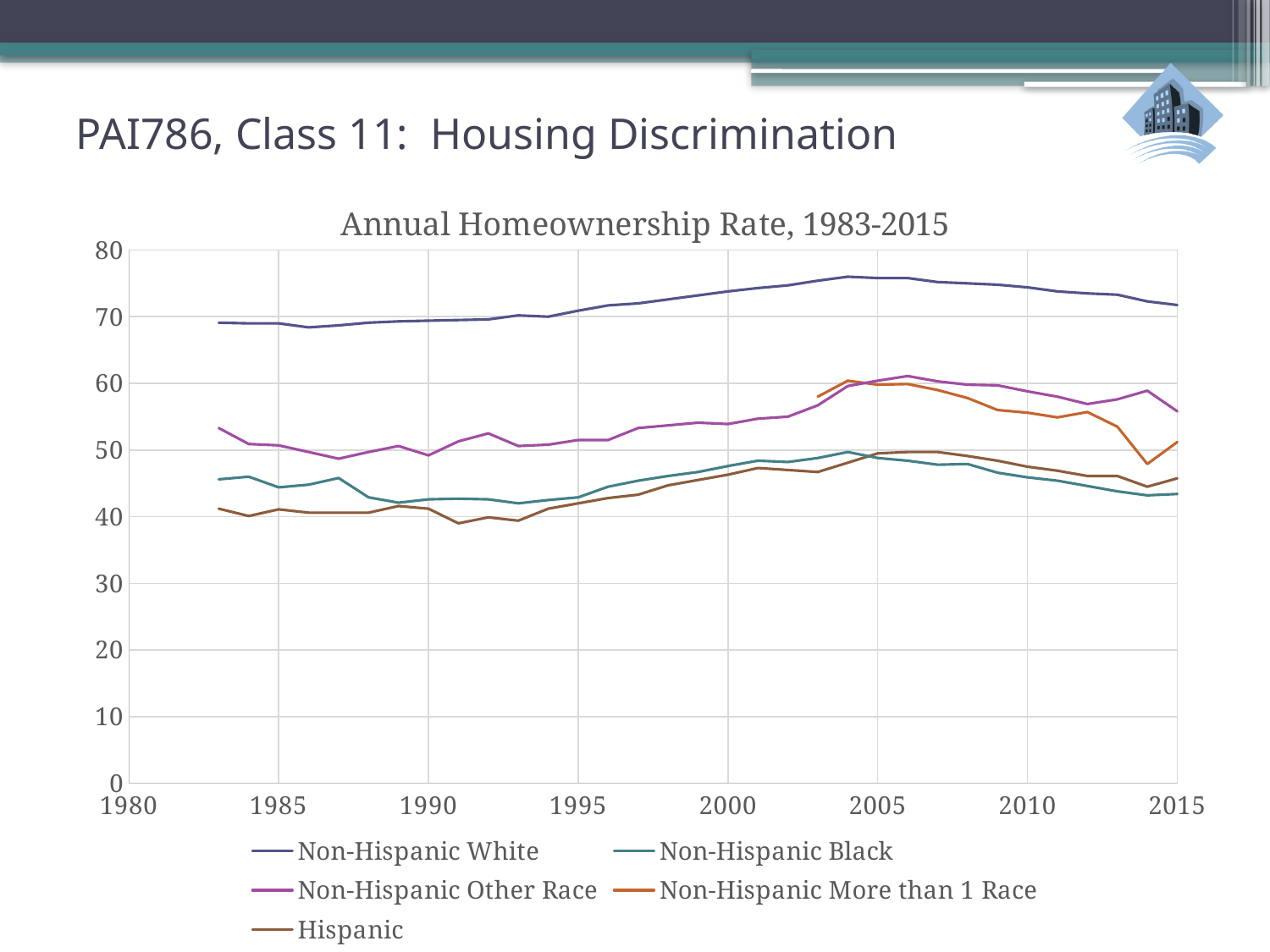
Is the value for Non-Hispanic White in 2005 greater or less than 70? greater How many series does the legend list? 5 Which series has the lowest value in 1983? Hispanic What kind of chart is shown on the slide? line chart In 2015, which is larger: the value for Non-Hispanic White or the value for Non-Hispanic Black? Non-Hispanic White Is the value for Non-Hispanic Black in 2005 greater or less than 60? less Which series begins latest on the chart, with no data before about 2003? Non-Hispanic More than 1 Race Is the value for Hispanic in 1983 greater or less than 50? less Does the Non-Hispanic White line rise or fall between 2005 and 2015? fall Which series has the highest homeownership rate across the whole period? Non-Hispanic White What is the title of the chart? Annual Homeownership Rate, 1983-2015